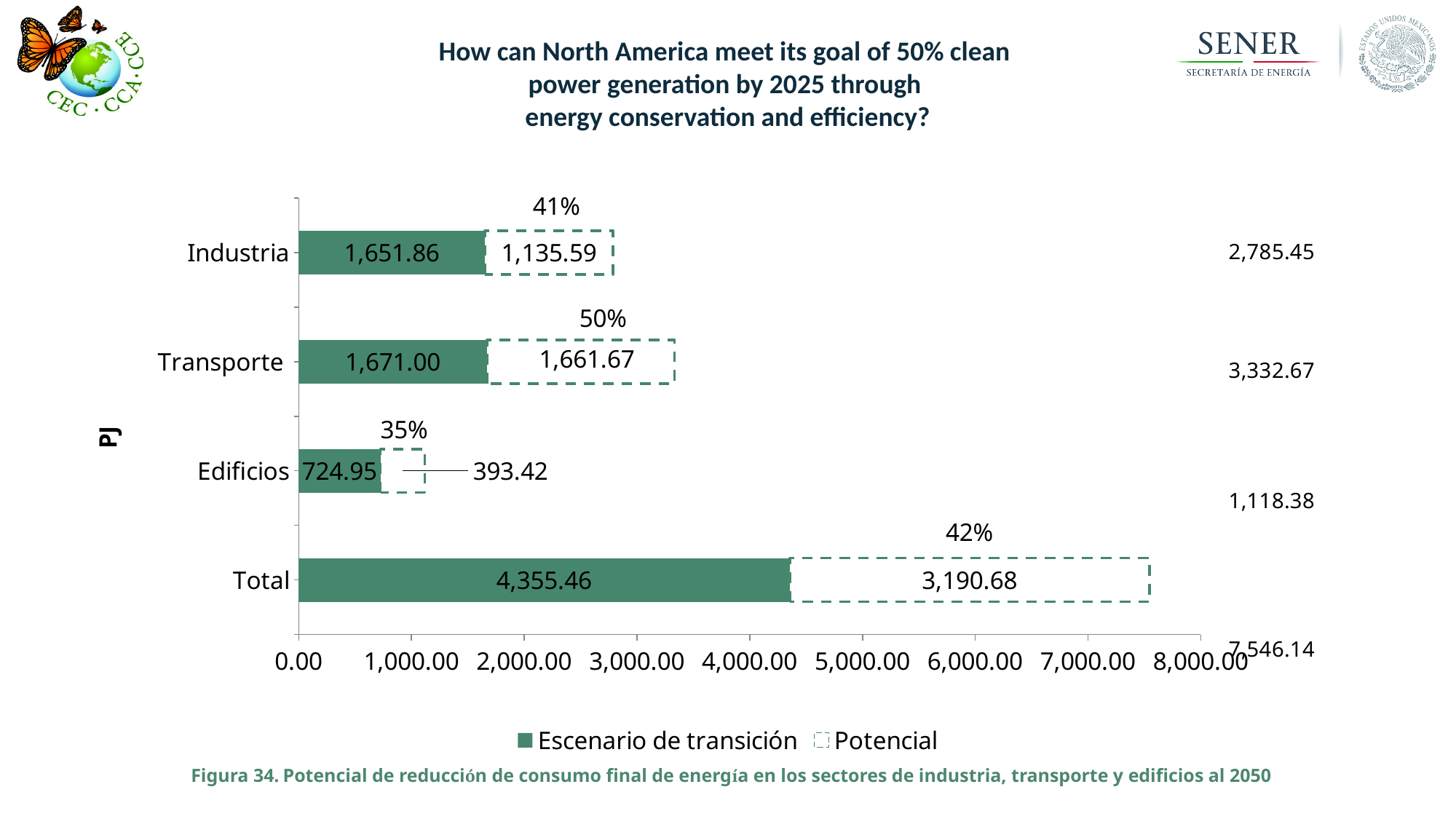
Which category has the lowest Escenario de transición value? Edificios What is the Escenario de transición value for Total? 4,355.46 What is the Potencial value for Transporte? 1,661.67 How many series does the legend list? 2 What is the value of Escenario de transición for Industria? 1,651.86 What is the difference between the Escenario de transición values for Transporte and Industria? 19.14 What is the Potencial value for Edificios? 393.42 What kind of chart is shown on the slide? Stacked bar chart Is the Potencial value for Industria or for Transporte larger? Transporte What percentage is shown above the Transporte bar? 50% Which category has the highest Potencial value? Total What is the combined total of the stacked bar for Edificios? 1,118.38